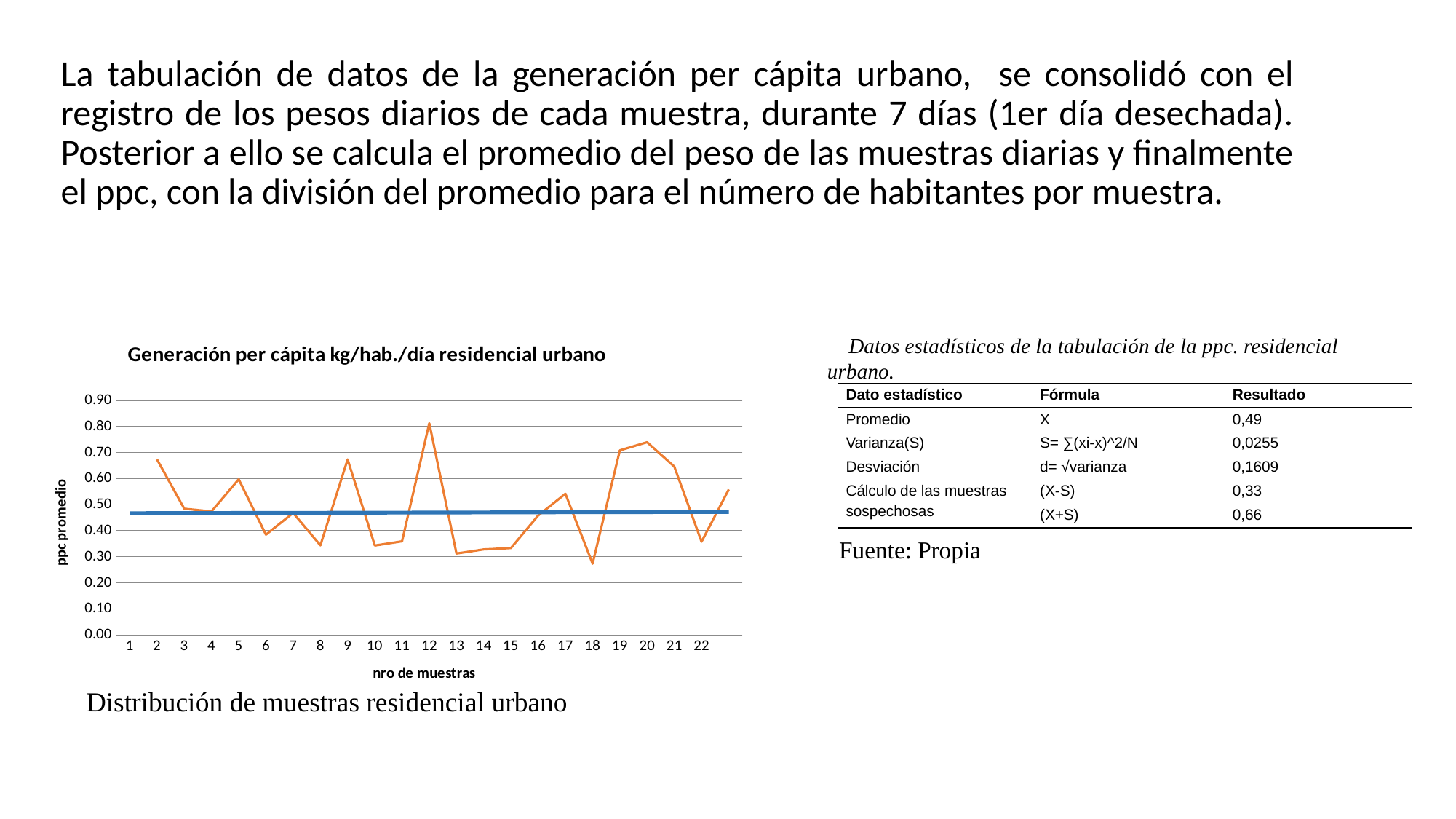
What is the label of the y axis of the chart? ppc promedio Is the value of the orange line at sample 18 greater or less than 0.30? less What kind of chart is shown on the slide? line chart Is the value of the orange line at sample 12 greater or less than 0.70? greater Which has the larger value on the orange line, sample 9 or sample 10? sample 9 Is the value of the orange line at sample 13 greater or less than 0.40? less Which has the larger value on the orange line, sample 12 or sample 18? sample 12 How many sample numbers are labelled on the x axis of the chart? 22 At which sample number does the orange line reach its highest value? 12 At which sample number does the orange line reach its lowest value? 18 What is the title of the chart? Generación per cápita kg/hab./día residencial urbano